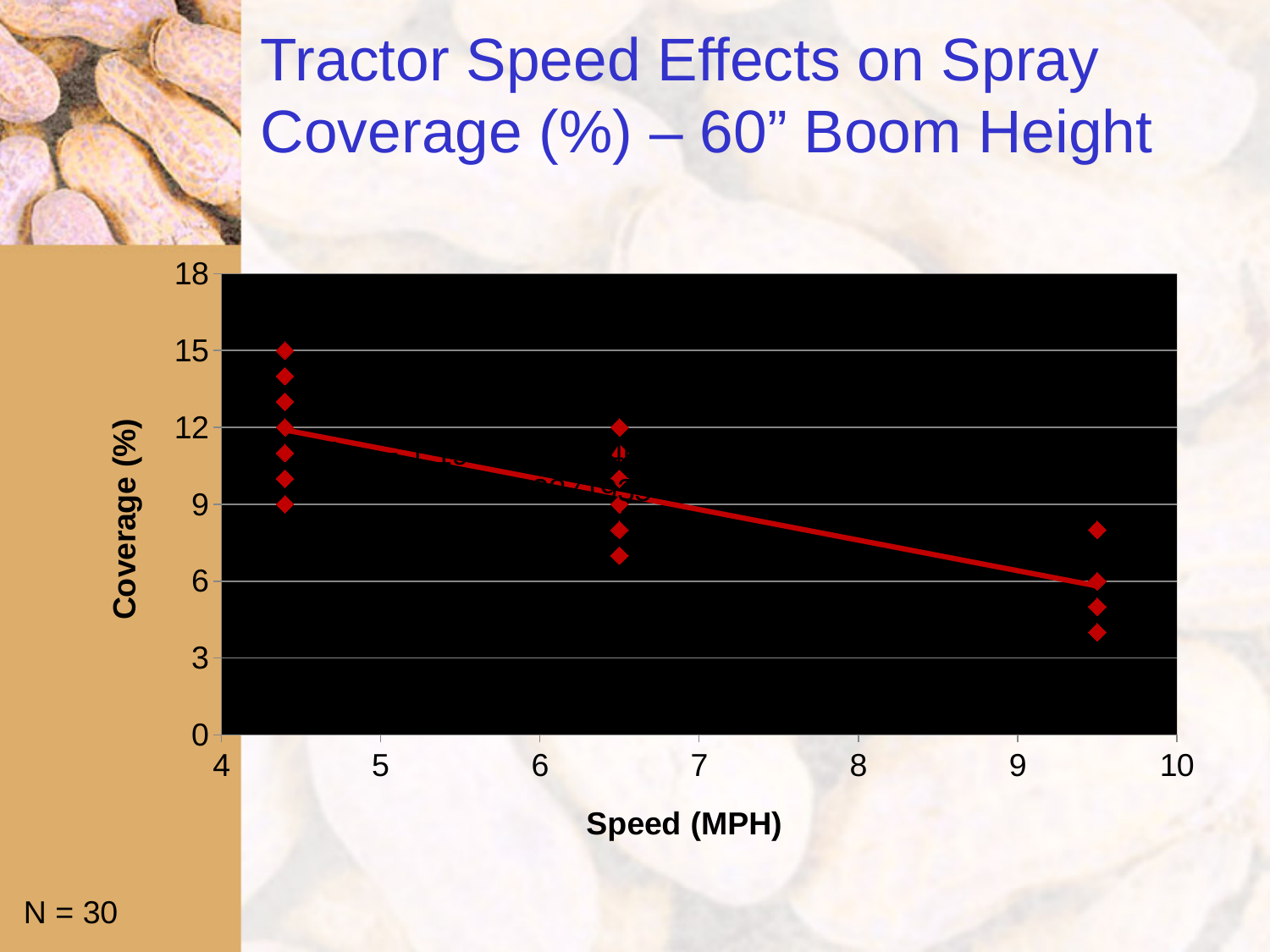
Does spray coverage rise or fall as tractor speed increases along the x axis? fall What is the sample size (N) stated on the slide? N = 30 How many distinct tractor speeds have data points plotted? 3 What kind of chart is shown on the slide? scatter chart What is the maximum value shown on the y axis? 18 What is the highest coverage value plotted on the chart? 15 Is the highest coverage value at about 6.5 MPH greater or less than 15? less Are the coverage values at the highest speed (about 9.5 MPH) greater or less than 9? less Are the coverage values at the lowest speed (about 4.4 MPH) greater or less than 6? greater What is the title of the chart on the slide? Tractor Speed Effects on Spray Coverage (%) – 60" Boom Height Which speed group has the higher coverage values: the points at about 4.4 MPH or the points at about 9.5 MPH? about 4.4 MPH What is the label of the x axis? Speed (MPH)